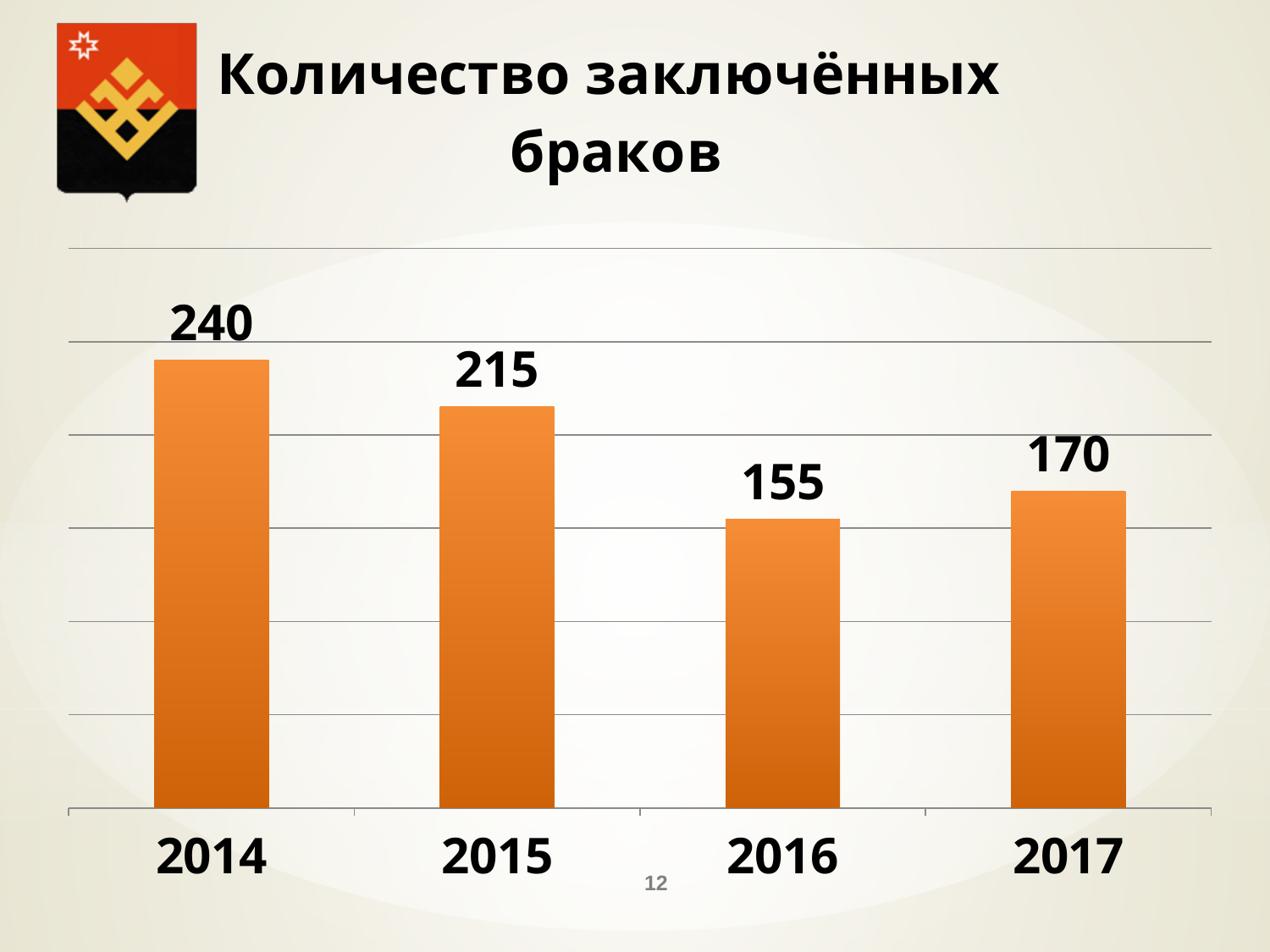
What is the difference between the values for 2014 and 2015? 25 How many years are shown on the chart? 4 What is the number of marriages in 2014? 240 Do the values rise or fall from 2014 to 2016? fall What is the difference between the values for 2017 and 2016? 15 What is the value shown for 2017? 170 Which year has the lowest value? 2016 What is the value shown for 2016? 155 What kind of chart is shown on the slide? bar chart What is the title of the chart? Количество заключённых браков Which is larger, the value for 2015 or the value for 2017? 2015 Which year has the highest value? 2014